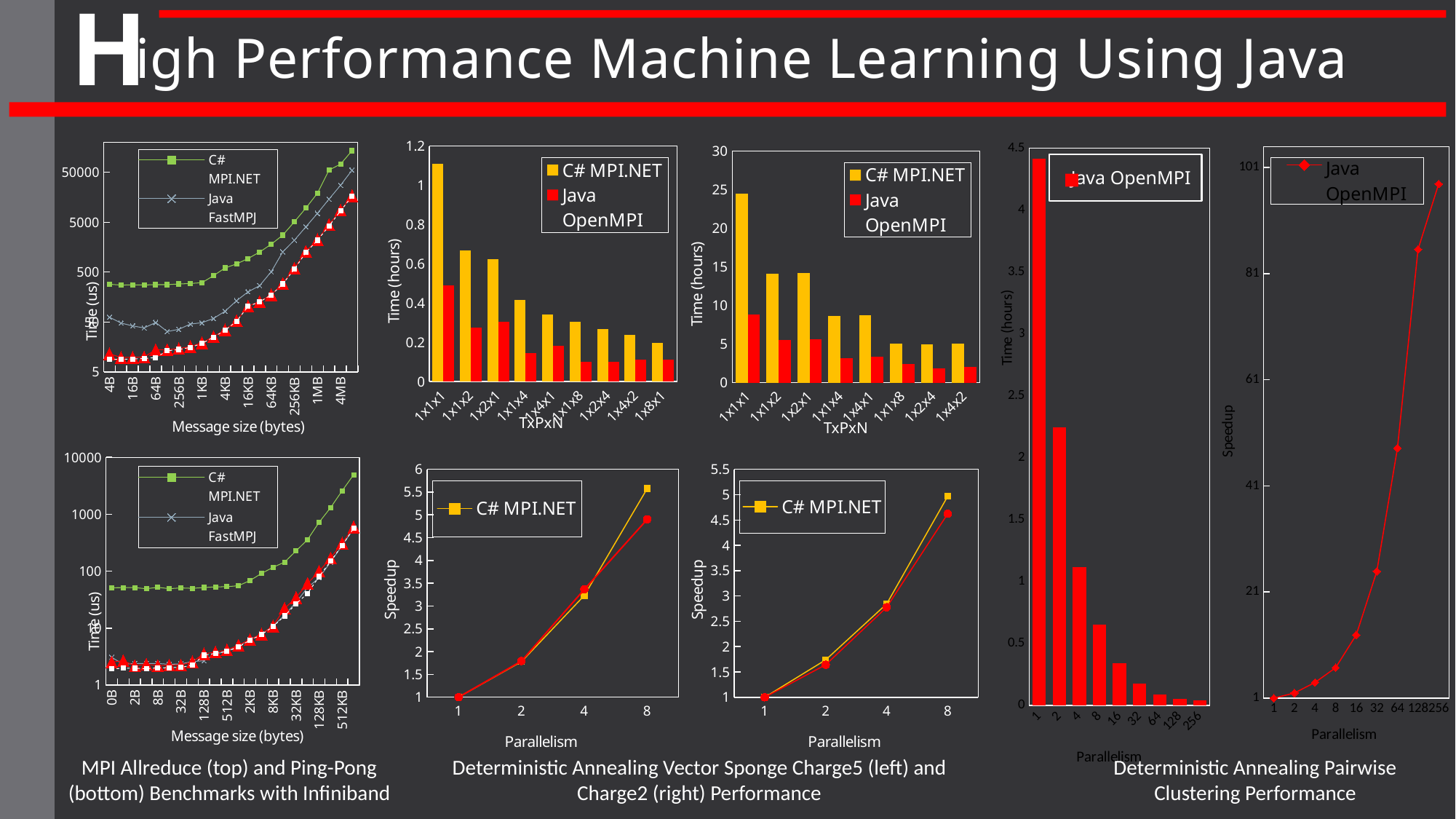
In the top bar chart with TxPxN categories from 1x1x1 to 1x8x1 (second chart from the left), how many categories are shown on the x axis? 9 In the Java OpenMPI Time (hours) vs Parallelism bar chart under the Deterministic Annealing Pairwise Clustering caption, do the values rise or fall as parallelism increases? fall In the top bar chart with TxPxN categories from 1x1x1 to 1x4x2 (third chart from the left), is the C# MPI.NET value for 1x1x1 greater or less than 20? greater In the Java OpenMPI Speedup vs Parallelism chart at the far right of the slide, is the speedup at parallelism 256 greater or less than 81? greater In the top bar chart with TxPxN categories from 1x1x1 to 1x8x1 (second chart from the left), which category has the highest C# MPI.NET time? 1x1x1 In the Java OpenMPI Time (hours) vs Parallelism bar chart under the Deterministic Annealing Pairwise Clustering caption, which parallelism value has the highest time? 1 In the top bar chart with TxPxN categories from 1x1x1 to 1x4x2 (third chart from the left), which series has the larger value for 1x1x2, C# MPI.NET or Java OpenMPI? C# MPI.NET In the top bar chart with TxPxN categories from 1x1x1 to 1x4x2 (third chart from the left), how many categories are shown on the x axis? 8 What kind of chart is the Java OpenMPI Time (hours) vs Parallelism chart under the Deterministic Annealing Pairwise Clustering caption? bar chart How many series does the legend list in the top bar chart with TxPxN categories from 1x1x1 to 1x8x1 (second chart from the left)? 2 In the Speedup vs Parallelism chart for Charge5 (bottom, second chart from the left), is the C# MPI.NET speedup at parallelism 8 greater or less than 5? greater